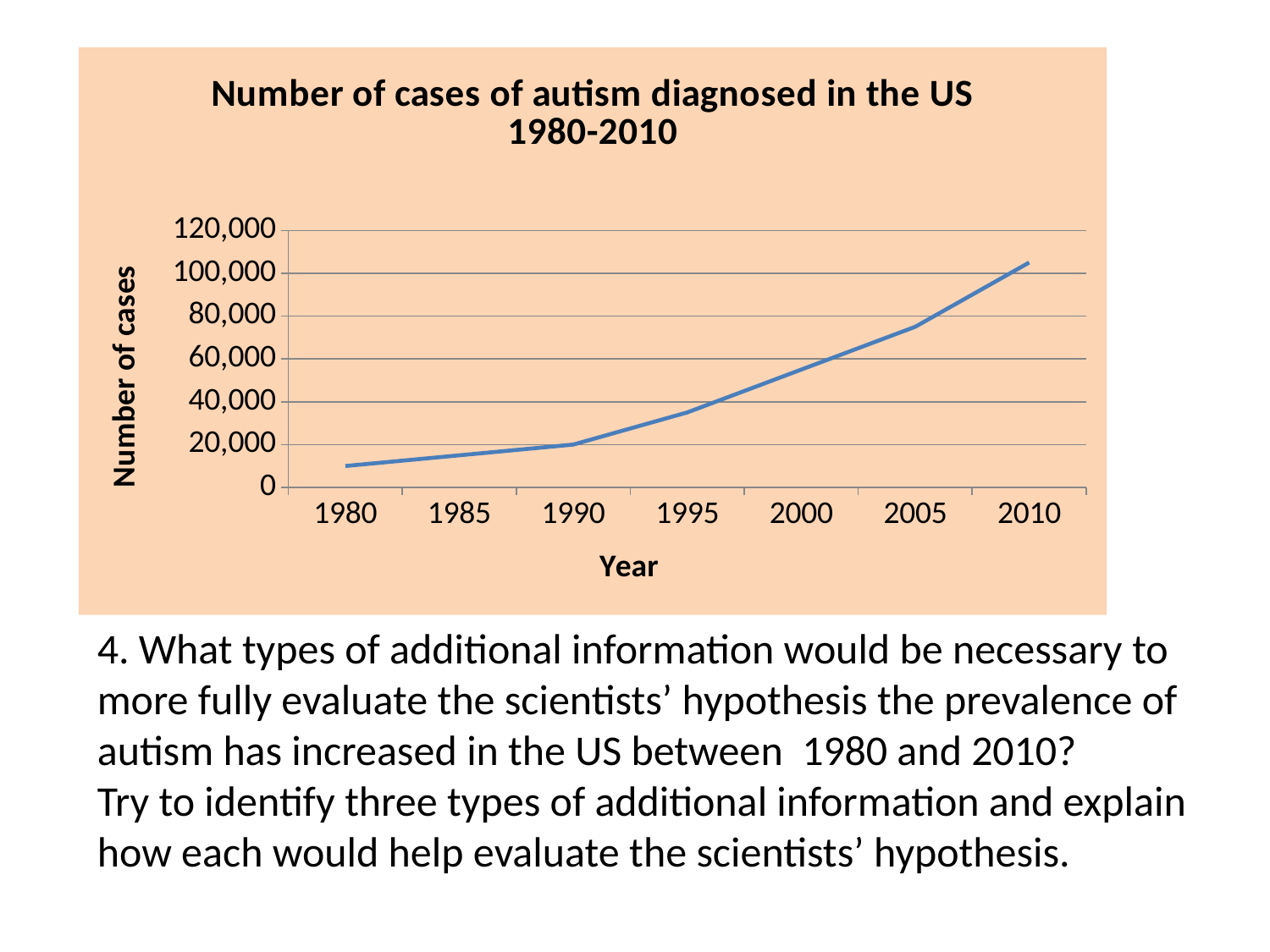
Is the value for 2010 greater or less than 100,000? greater Which year has the lowest number of cases? 1980 Which year has more cases, 1995 or 2005? 2005 Is the value for 2005 greater or less than 80,000? less Is the value for 1980 greater or less than 20,000? less Do the values rise or fall from 1980 to 2010? rise Which year has the highest number of cases? 2010 How many years are marked on the x axis of the chart? 7 What kind of chart is shown on the slide? line chart What is the title of the chart? Number of cases of autism diagnosed in the US 1980-2010 What is the label on the y axis of the chart? Number of cases